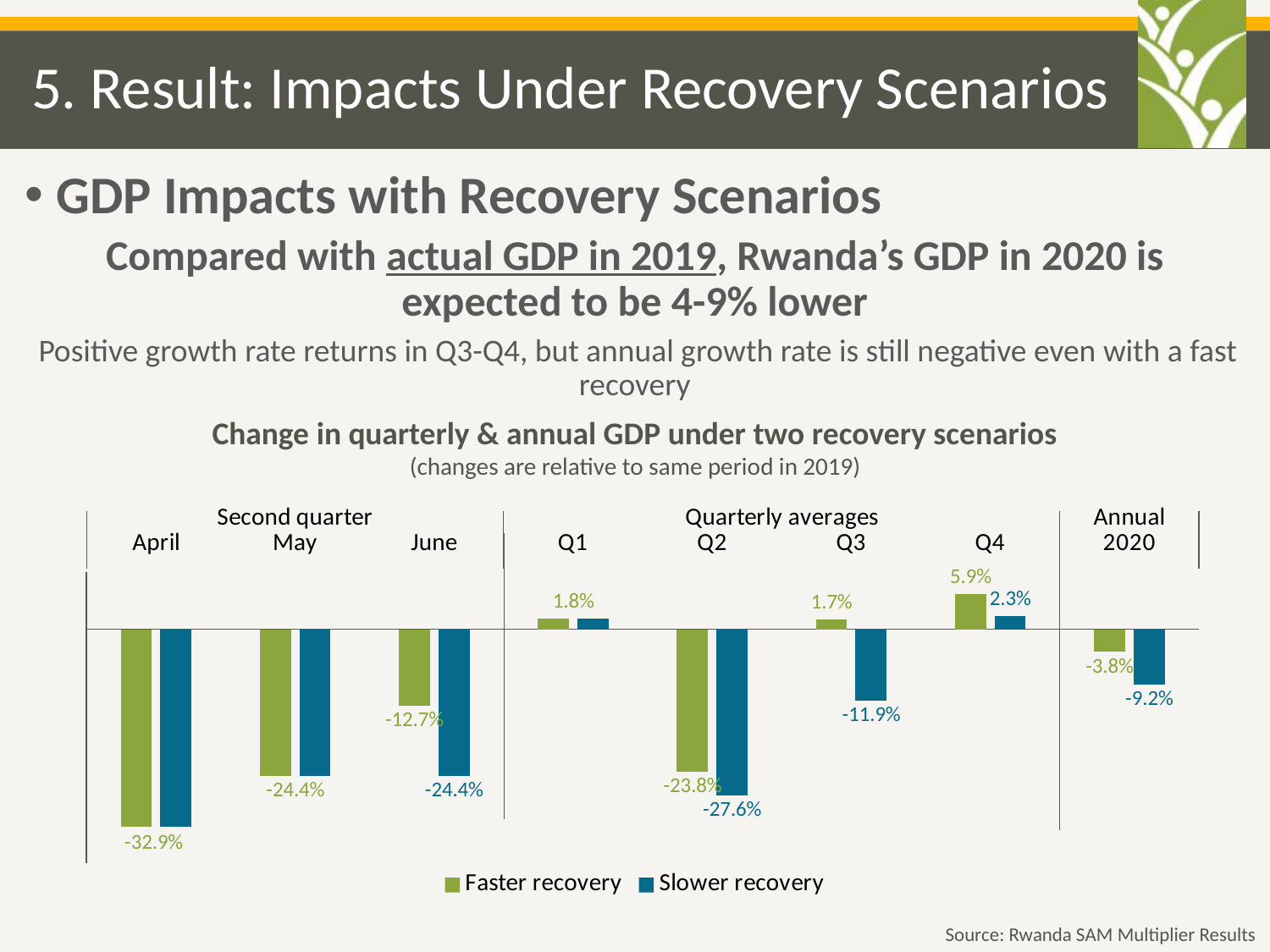
What kind of chart is shown on the slide? Bar chart How many series does the legend list? 2 What is the value for Slower recovery in Q2? -27.6% What is the value for Faster recovery in June? -12.7% Which category has the lowest value for the Faster recovery series? April How many categories are shown along the x axis of the chart? 8 Which category has the highest value for the Faster recovery series? Q4 What is the Slower recovery value for Annual 2020? -9.2% In Q4, which series has the larger value, Faster recovery or Slower recovery? Faster recovery For Annual 2020, what is the difference between the Faster recovery and Slower recovery values? 5.4 percentage points What is the value for Slower recovery in Q3? -11.9% What is the Faster recovery value for Annual 2020? -3.8%